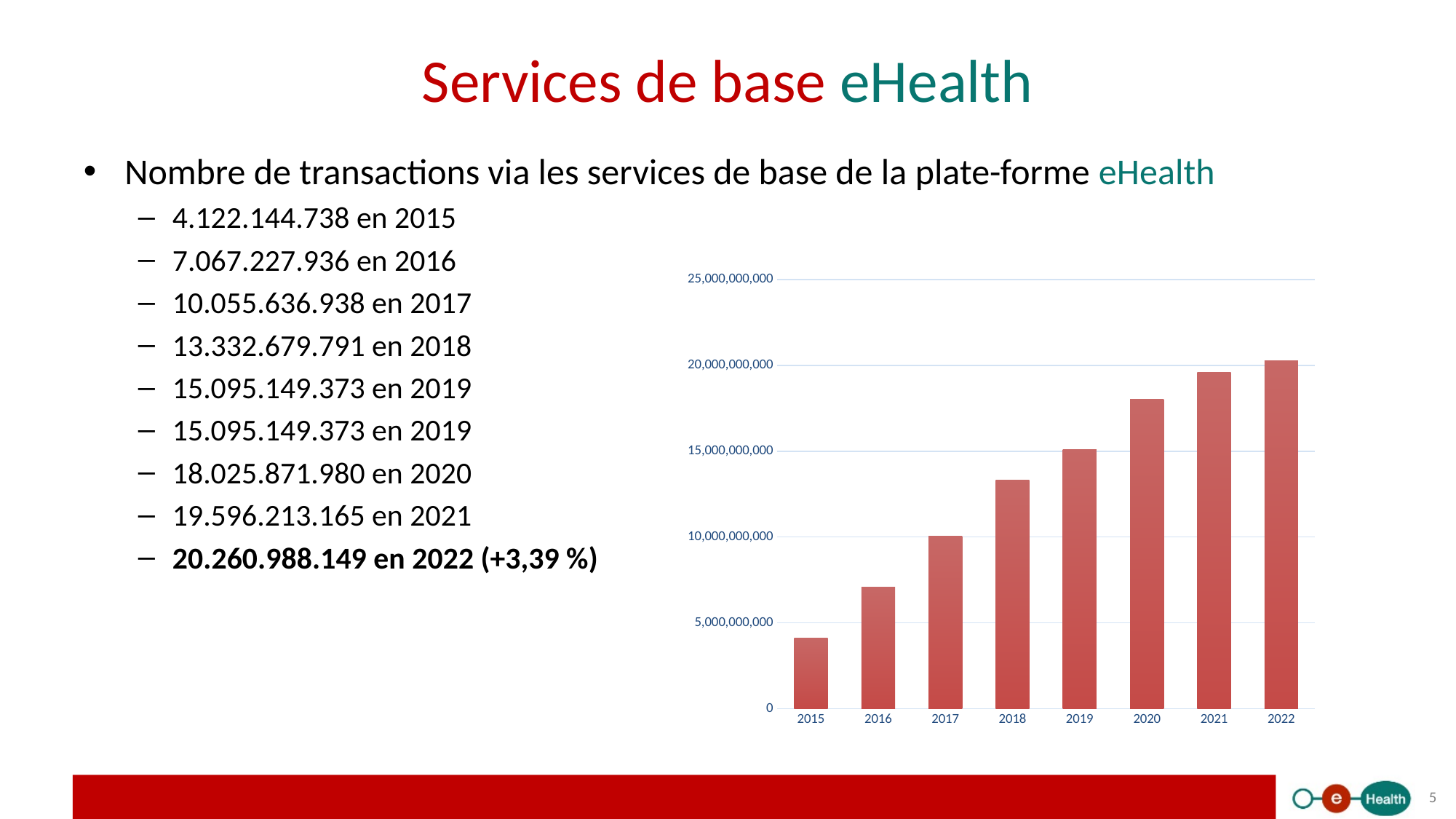
Is the value for 2020 greater or less than 20,000,000,000? less Which year has the lowest bar on the chart? 2015 How many years are plotted on the chart? 8 What kind of chart is shown on the slide? bar chart Which is larger, the value for 2020 or the value for 2021? 2021 What is the highest value shown on the vertical axis of the chart? 25,000,000,000 According to the slide, what is the number of transactions in 2022? 20.260.988.149 Which year has the highest bar on the chart? 2022 Do the values rise or fall from 2015 to 2022? rise Is the value for 2018 greater or less than 10,000,000,000? greater Is the value for 2016 greater or less than 5,000,000,000? greater